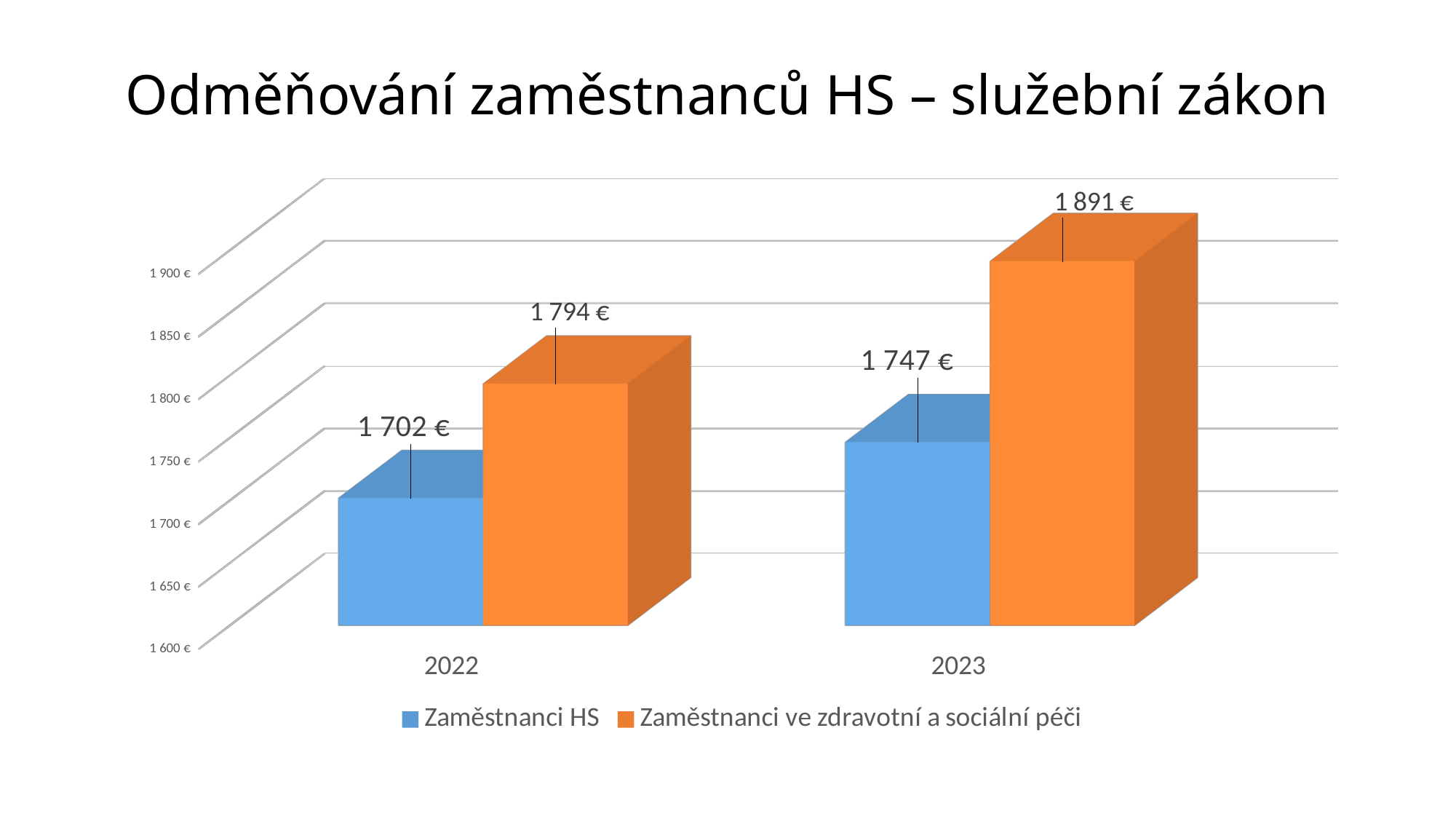
What is the value for Zaměstnanci HS in 2022? 1 702 € How many series does the legend list? 2 What is the value for Zaměstnanci ve zdravotní a sociální péči in 2022? 1 794 € What is the value for Zaměstnanci ve zdravotní a sociální péči in 2023? 1 891 € Which year has the lowest value for Zaměstnanci HS? 2022 Which year has the highest value for Zaměstnanci ve zdravotní a sociální péči? 2023 What is the value for Zaměstnanci HS in 2023? 1 747 € By how much did the value for Zaměstnanci HS increase from 2022 to 2023? 45 € What kind of chart is shown on the slide? Bar chart Which is larger in 2022: Zaměstnanci HS or Zaměstnanci ve zdravotní a sociální péči? Zaměstnanci ve zdravotní a sociální péči How many years are shown on the x axis? 2 What is the difference between Zaměstnanci ve zdravotní a sociální péči and Zaměstnanci HS in 2023? 144 €